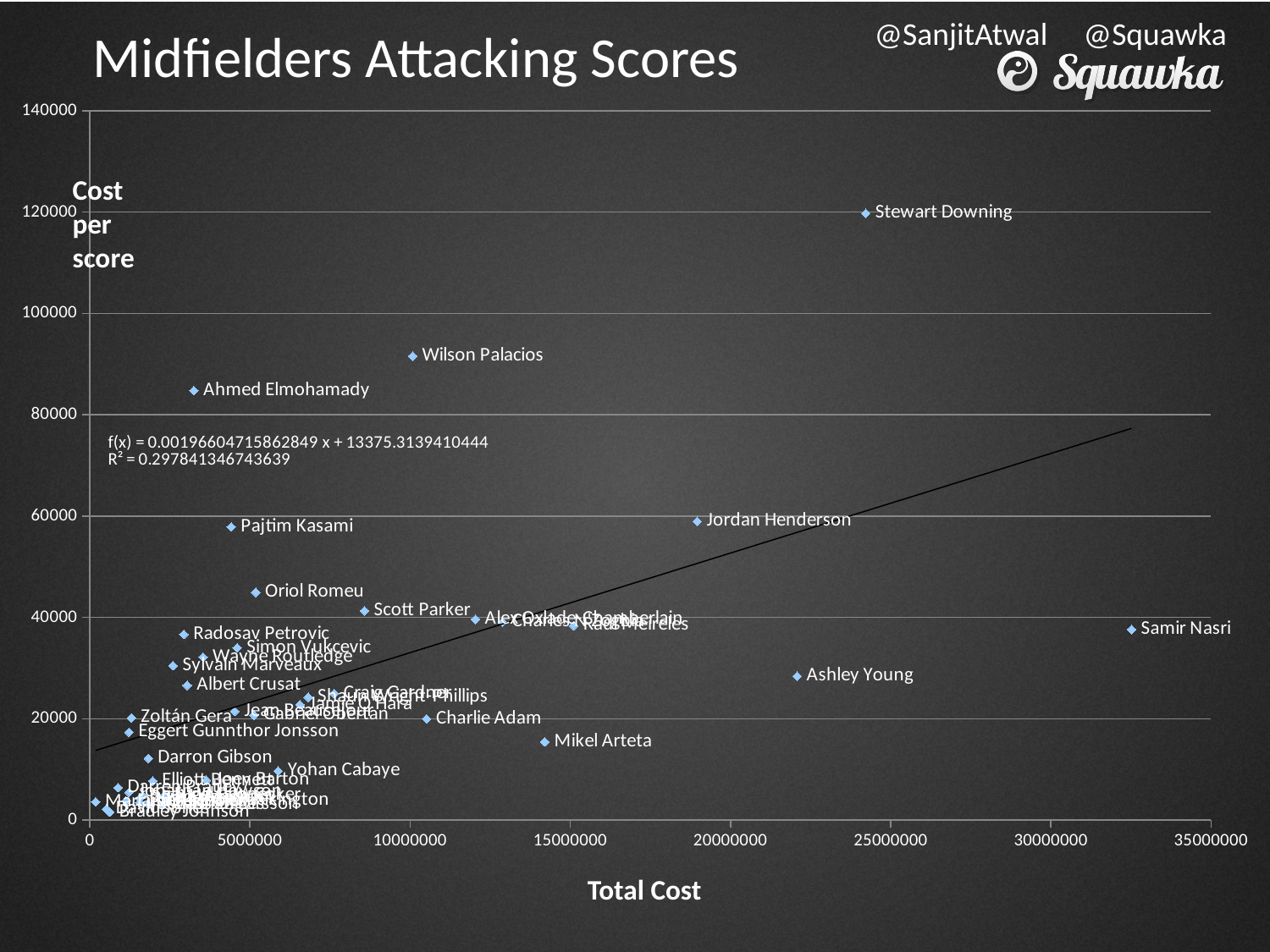
What kind of chart is shown on the slide? Scatter chart What is the R² value printed on the chart? 0.297841346743639 Is the total cost for Samir Nasri greater or less than 30000000? greater Which player has the highest total cost? Samir Nasri Is the cost per score for Stewart Downing greater or less than 100000? greater Is the cost per score for Ashley Young greater or less than 40000? less Who has the higher cost per score, Stewart Downing or Wilson Palacios? Stewart Downing Which player has the highest cost per score? Stewart Downing Does the fitted trend line rise or fall as total cost increases? Rises